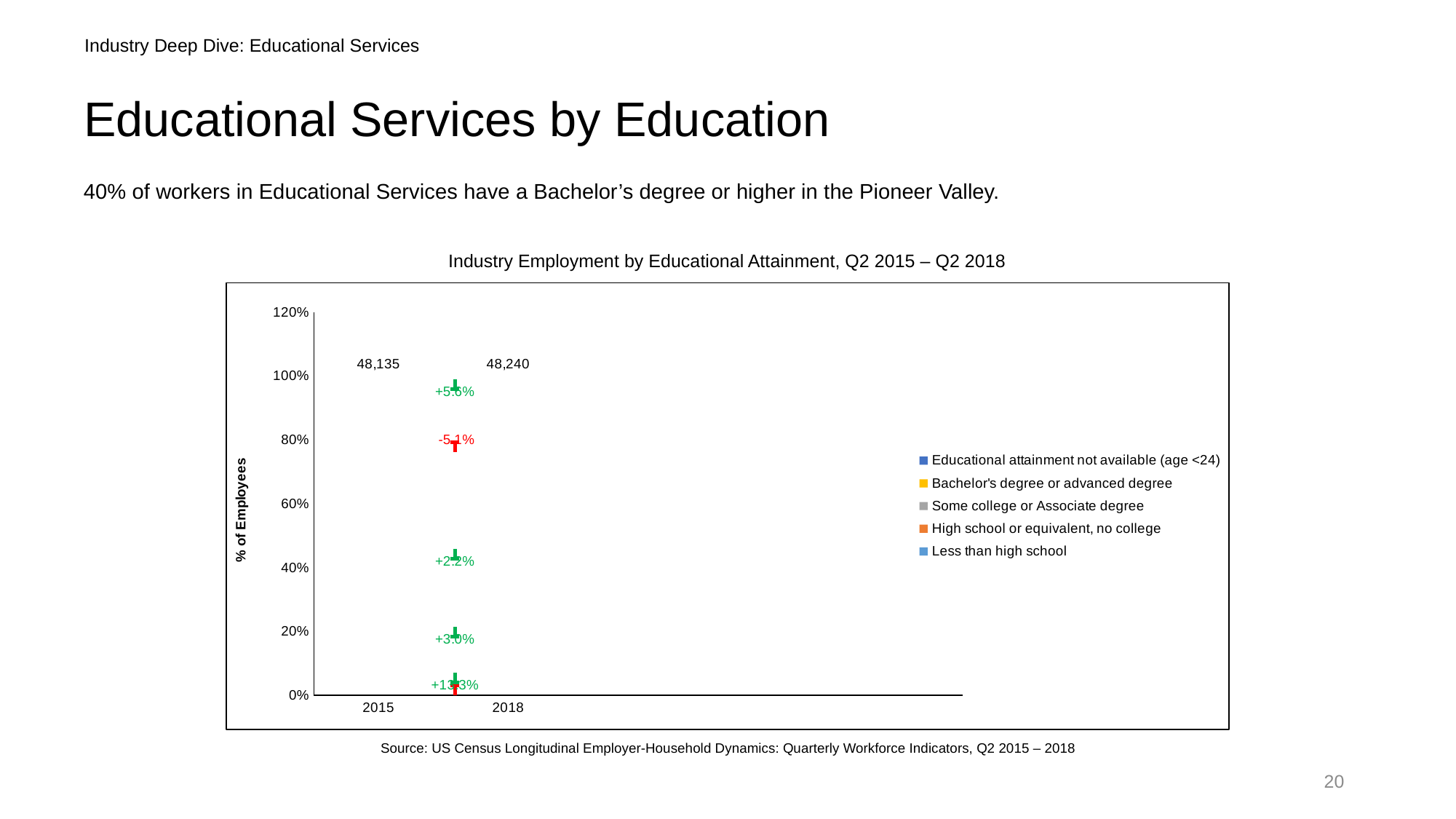
How many years (categories) are shown on the x axis of the chart? 2 What is the label on the y axis of the chart? % of Employees What is the topmost percentage change label shown between the 2015 and 2018 bars? +5.6% What is the only negative percentage change label shown between the 2015 and 2018 bars? -5.1% How many series does the chart's legend list? 5 What is the highest value shown on the y axis of the chart? 120% What is the title of the chart? Industry Employment by Educational Attainment, Q2 2015 – Q2 2018 What is the difference between the total employment figures printed for 2018 and 2015? 105 What total employment figure is printed above the 2015 bar? 48,135 Which year has the larger total employment figure printed above it, 2015 or 2018? 2018 What total employment figure is printed above the 2018 bar? 48,240